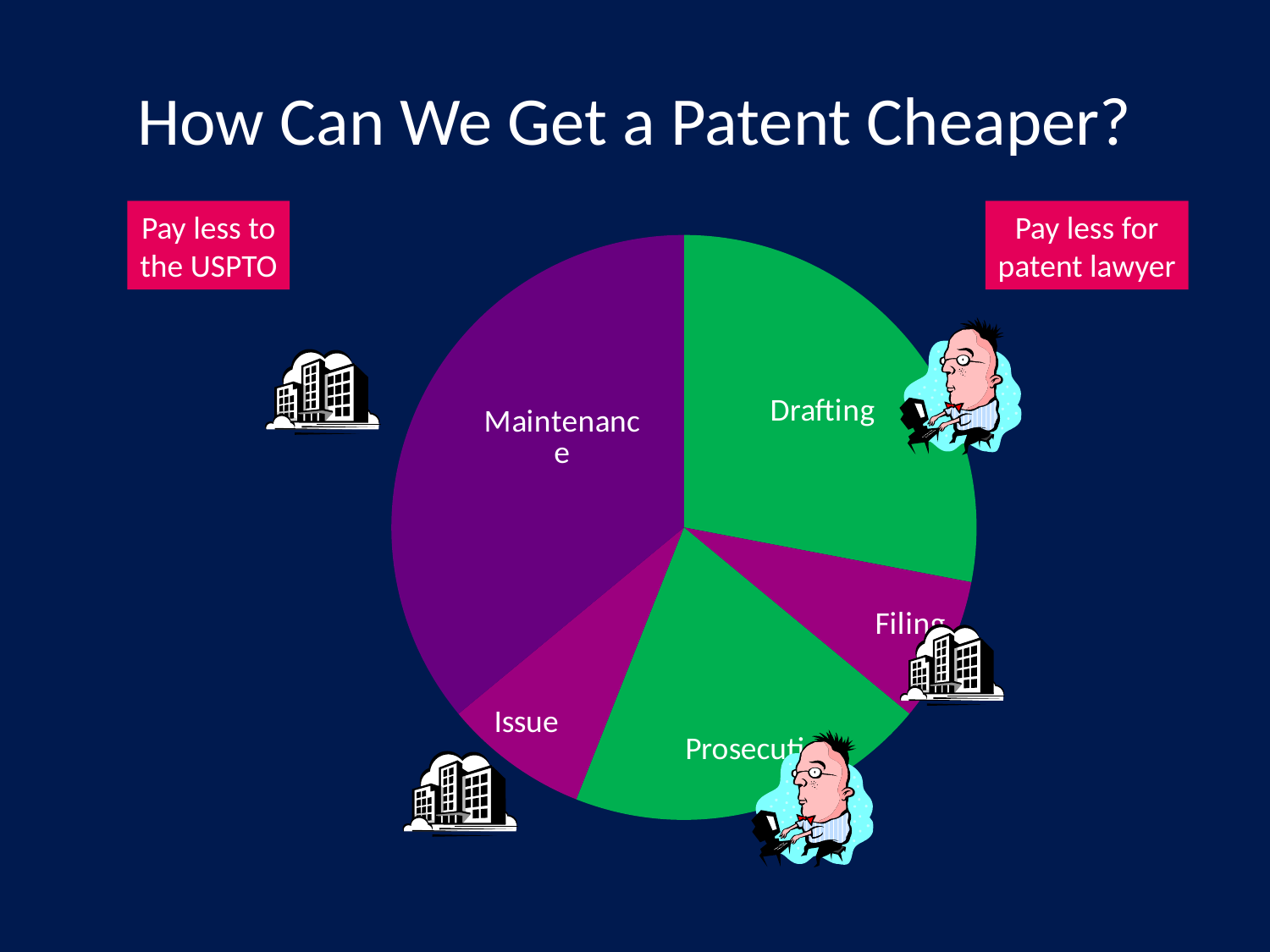
Which slice is larger, Drafting or Issue? Drafting Which slice of the pie chart is the largest? Maintenance What is the title of the slide containing the pie chart? How Can We Get a Patent Cheaper? How many slices does the pie chart have? 5 Which slice is larger, Maintenance or Drafting? Maintenance What colour is the Drafting slice of the pie chart? Green Which slice is larger, Prosecution or Filing? Prosecution What kind of chart is shown on the slide? Pie chart